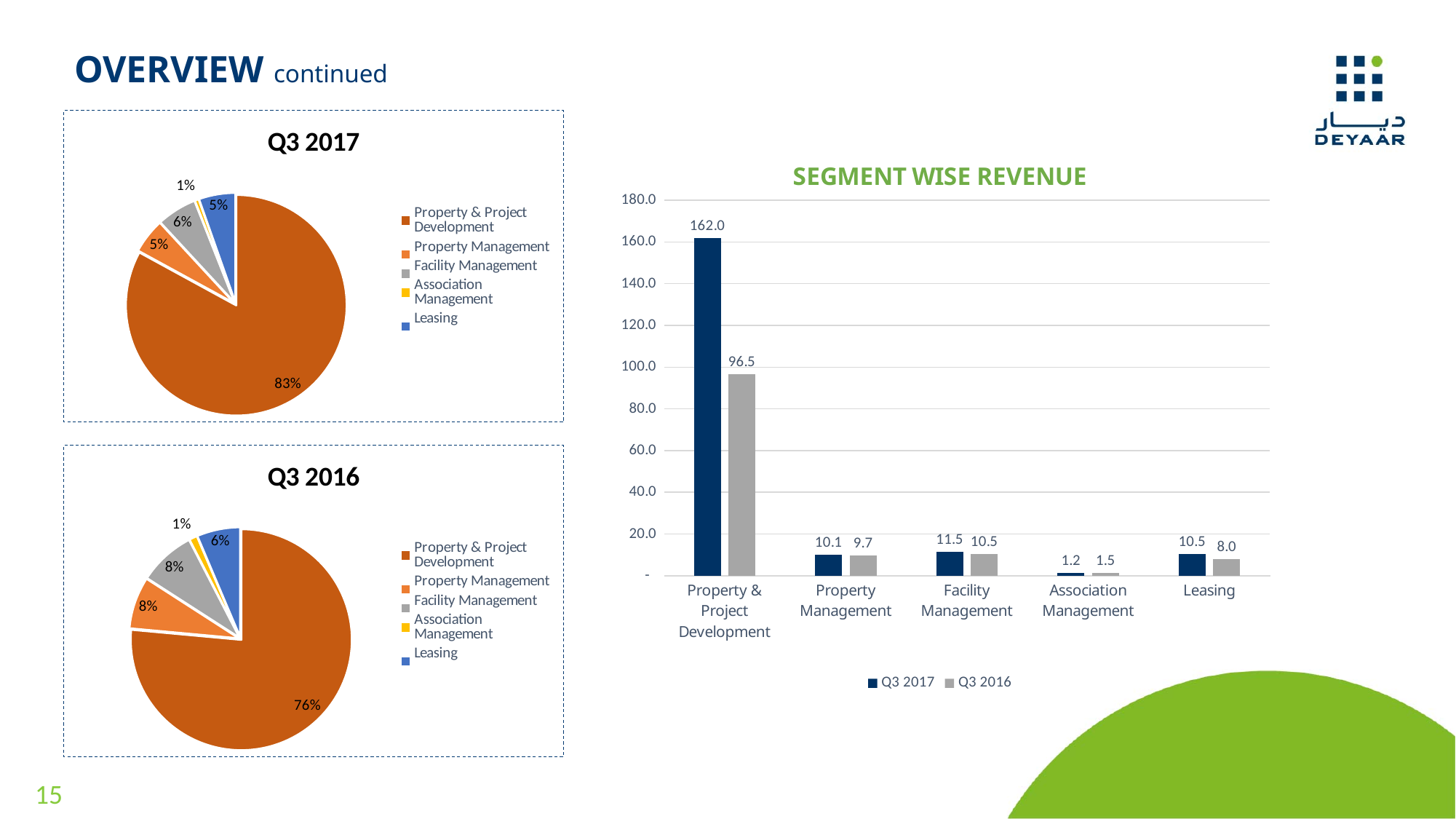
In the Q3 2017 pie chart, what share does Property & Project Development have? 83% In the Segment Wise Revenue bar chart, which segment has the lowest Q3 2017 revenue? Association Management In the Segment Wise Revenue bar chart, what is the Q3 2016 value for Leasing? 8.0 In the Q3 2017 pie chart, what colour is the Leasing slice? Blue In the Segment Wise Revenue bar chart, what is the difference between the Q3 2017 and Q3 2016 values for Property & Project Development? 65.5 In the Segment Wise Revenue bar chart, what is the Q3 2017 value for Property & Project Development? 162.0 In the Segment Wise Revenue bar chart, which is larger for Facility Management: Q3 2017 or Q3 2016? Q3 2017 In the Segment Wise Revenue bar chart, how many series does the legend list? 2 In the Q3 2016 pie chart, what share does Facility Management have? 8% What kind of chart is the Segment Wise Revenue chart? Bar chart In the Segment Wise Revenue bar chart, how many segments are shown on the x axis? 5 In the Q3 2016 pie chart, which segment has the smallest share? Association Management